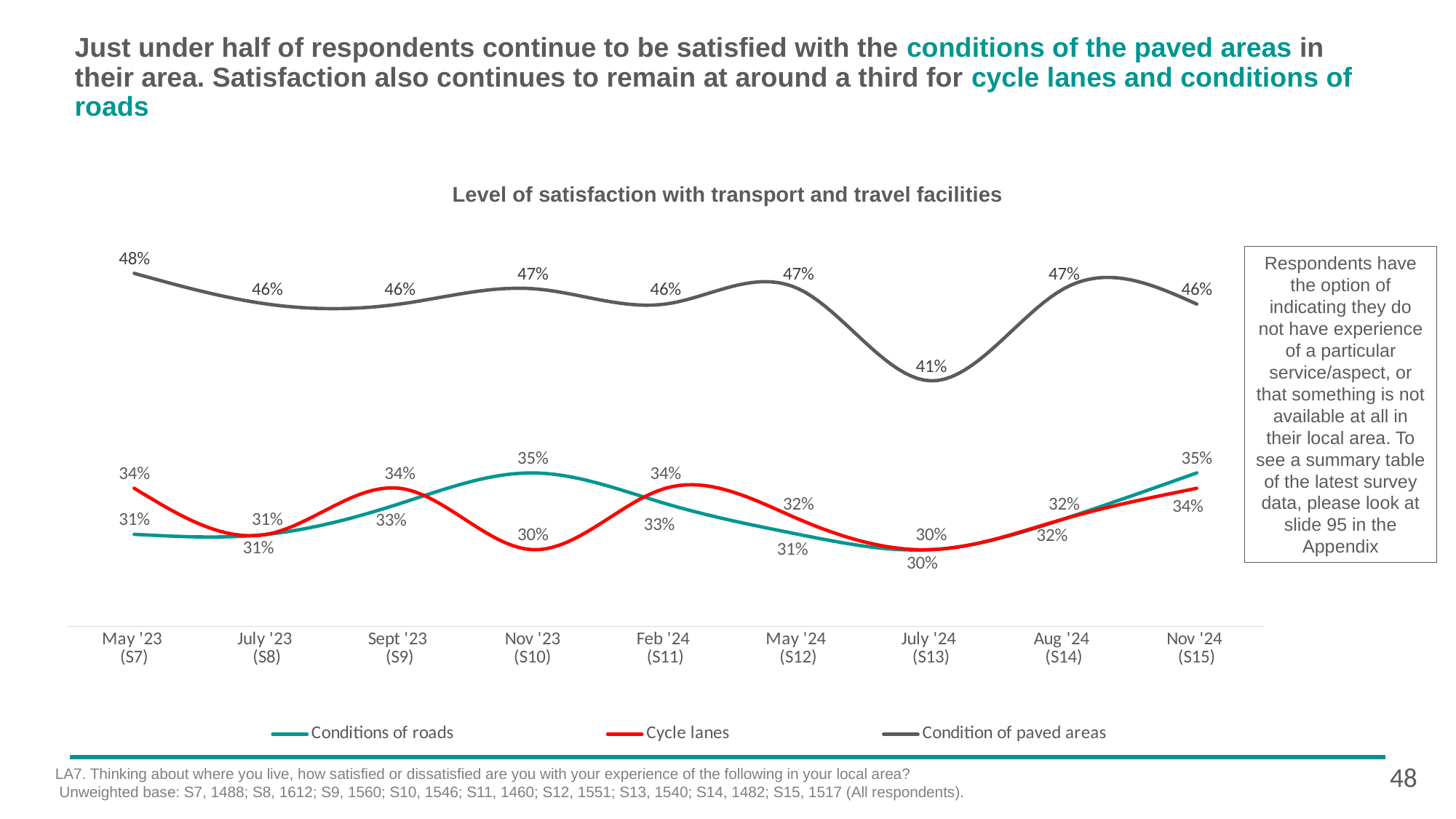
What is the satisfaction value for Conditions of roads in Nov '24 (S15)? 35% What is the difference between Condition of paved areas and Conditions of roads in May '23 (S7)? 17 percentage points Which series has the higher value in Nov '23 (S10): Conditions of roads or Cycle lanes? Conditions of roads What is the satisfaction value for Condition of paved areas in May '23 (S7)? 48% What is the title of the chart? Level of satisfaction with transport and travel facilities In which survey wave is Condition of paved areas at its lowest? July '24 (S13) What is the satisfaction value for Cycle lanes in Nov '23 (S10)? 30% In which survey wave is Condition of paved areas at its highest? May '23 (S7) What type of chart is shown on the slide? line chart How many survey waves (points) are plotted along the x axis? 9 What is the satisfaction value for Condition of paved areas in July '24 (S13)? 41% How many series does the legend list? 3